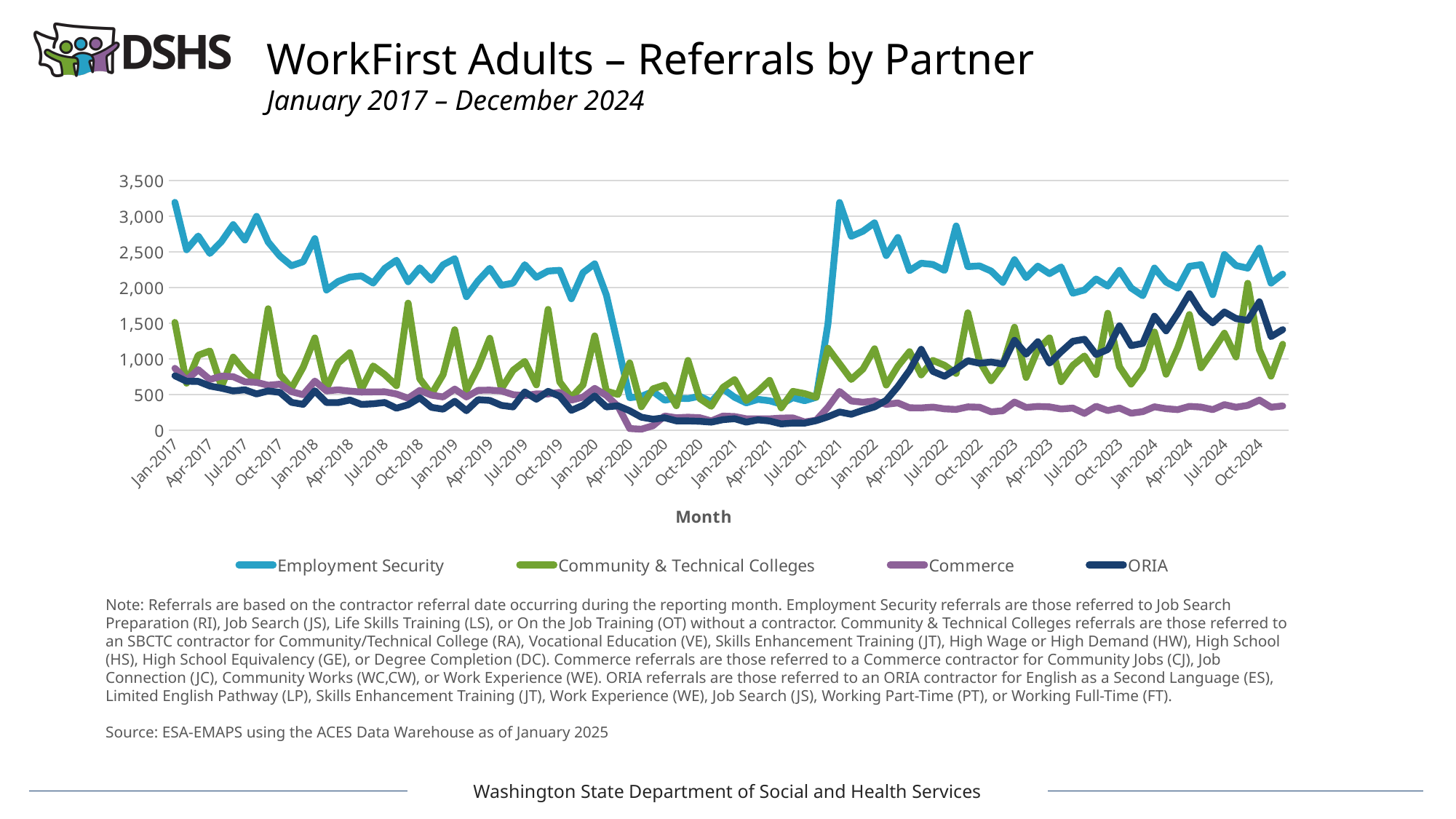
Does the ORIA series generally rise or fall from Jul-2021 to Oct-2024? rise Is the value for ORIA in Apr-2024 greater or less than 1,500? greater Is the value for Commerce in Apr-2020 greater or less than 500? less Is the value for Employment Security in Jul-2020 greater or less than 1,000? less Which series has the highest value in Jan-2017? Employment Security What is the title of the x axis? Month How many series does the legend list? 4 Which series has the lowest value in Oct-2024? Commerce What are the four series named in the legend? Employment Security, Community & Technical Colleges, Commerce, ORIA What kind of chart is shown on the slide? line chart In Oct-2024, which is larger, the value for ORIA or the value for Commerce? ORIA